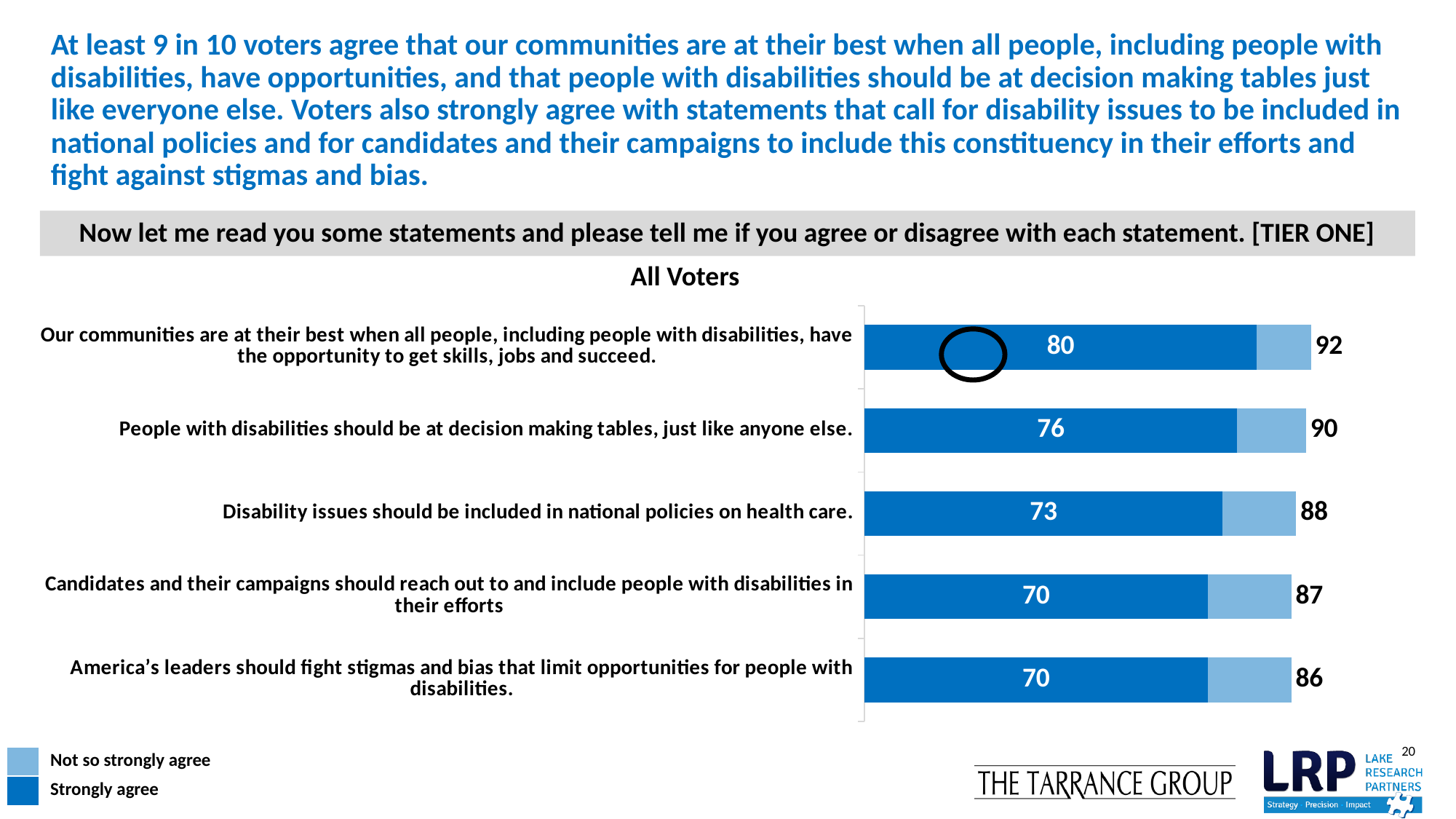
What is the total agreement value shown for the statement 'People with disabilities should be at decision making tables, just like anyone else'? 90 Which statement has the highest 'Strongly agree' value? Our communities are at their best when all people, including people with disabilities, have the opportunity to get skills, jobs and succeed. Which has a larger 'Strongly agree' value: the statement about disability issues in national health care policies or the statement about candidates and campaigns reaching out to people with disabilities? Disability issues should be included in national policies on health care. What kind of chart is shown on the slide? Stacked bar chart Which statement has the lowest total agreement value? America's leaders should fight stigmas and bias that limit opportunities for people with disabilities. What total value is shown at the end of the bar for 'America's leaders should fight stigmas and bias that limit opportunities for people with disabilities'? 86 What are the two legend entries for the chart? Not so strongly agree; Strongly agree What is the difference between the total agreement for the 'communities are at their best' statement (92) and the 'decision making tables' statement (90)? 2 How many series does the legend list? 2 How many statements are plotted in the chart? 5 What percentage of all voters strongly agree that our communities are at their best when all people, including people with disabilities, have the opportunity to get skills, jobs and succeed? 80 What is the 'Strongly agree' value for the statement that disability issues should be included in national policies on health care? 73